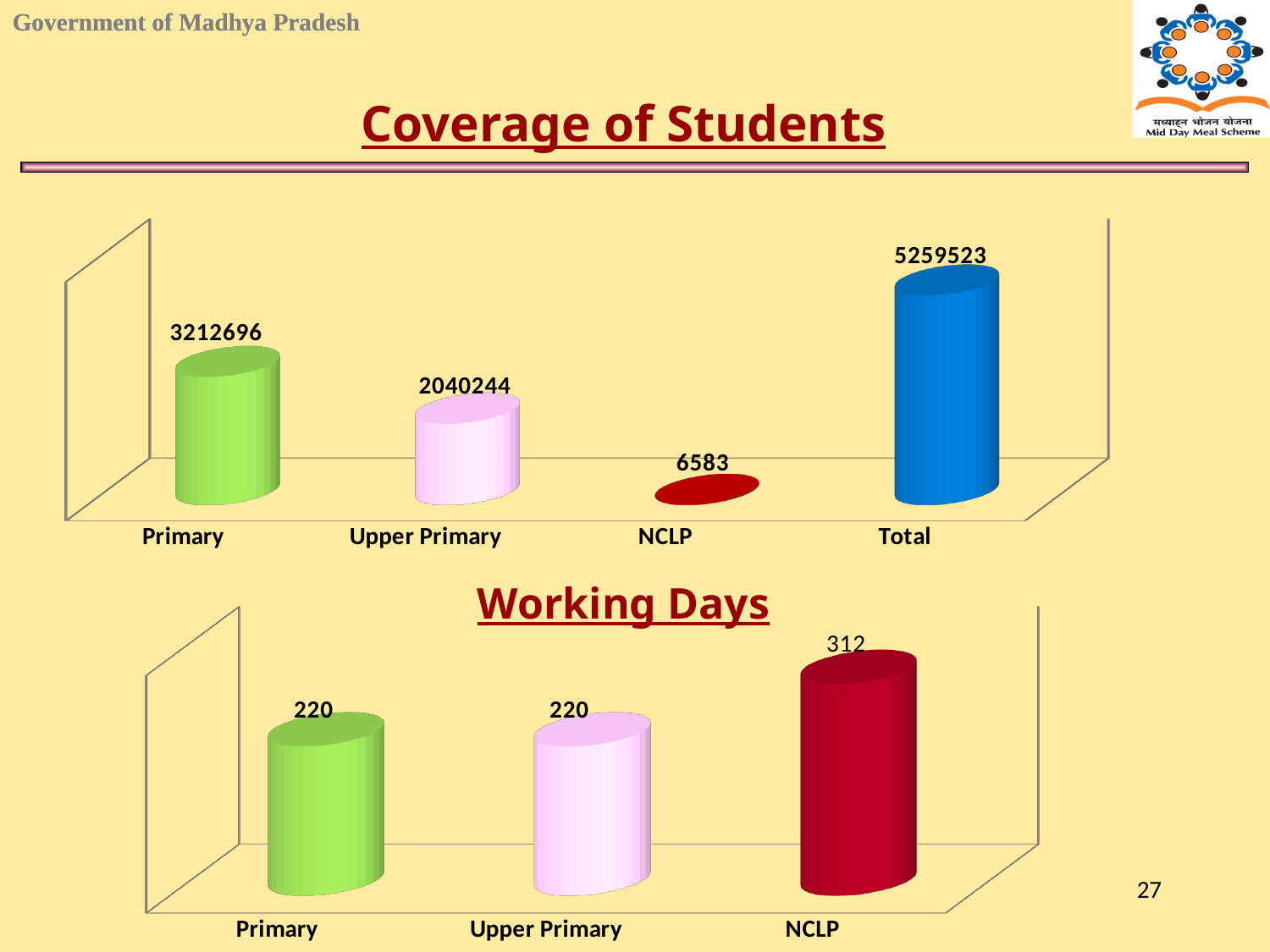
What kind of chart is the Working Days chart? Bar chart In the Coverage of Students chart, which category has the lowest value? NCLP In the Working Days chart, what is the value for Upper Primary? 220 In the Coverage of Students chart, what is the value for Primary? 3212696 In the Coverage of Students chart, what is the difference between Primary and Upper Primary? 1172452 In the Working Days chart, which category has the highest value? NCLP In the Working Days chart, what is the difference between NCLP and Primary? 92 In the Working Days chart, what is the value for NCLP? 312 In the Coverage of Students chart, what is the value for NCLP? 6583 In the Coverage of Students chart, which category has the highest value? Total In the Coverage of Students chart, what is the value for Total? 5259523 In the Coverage of Students chart, how many categories are shown? 4